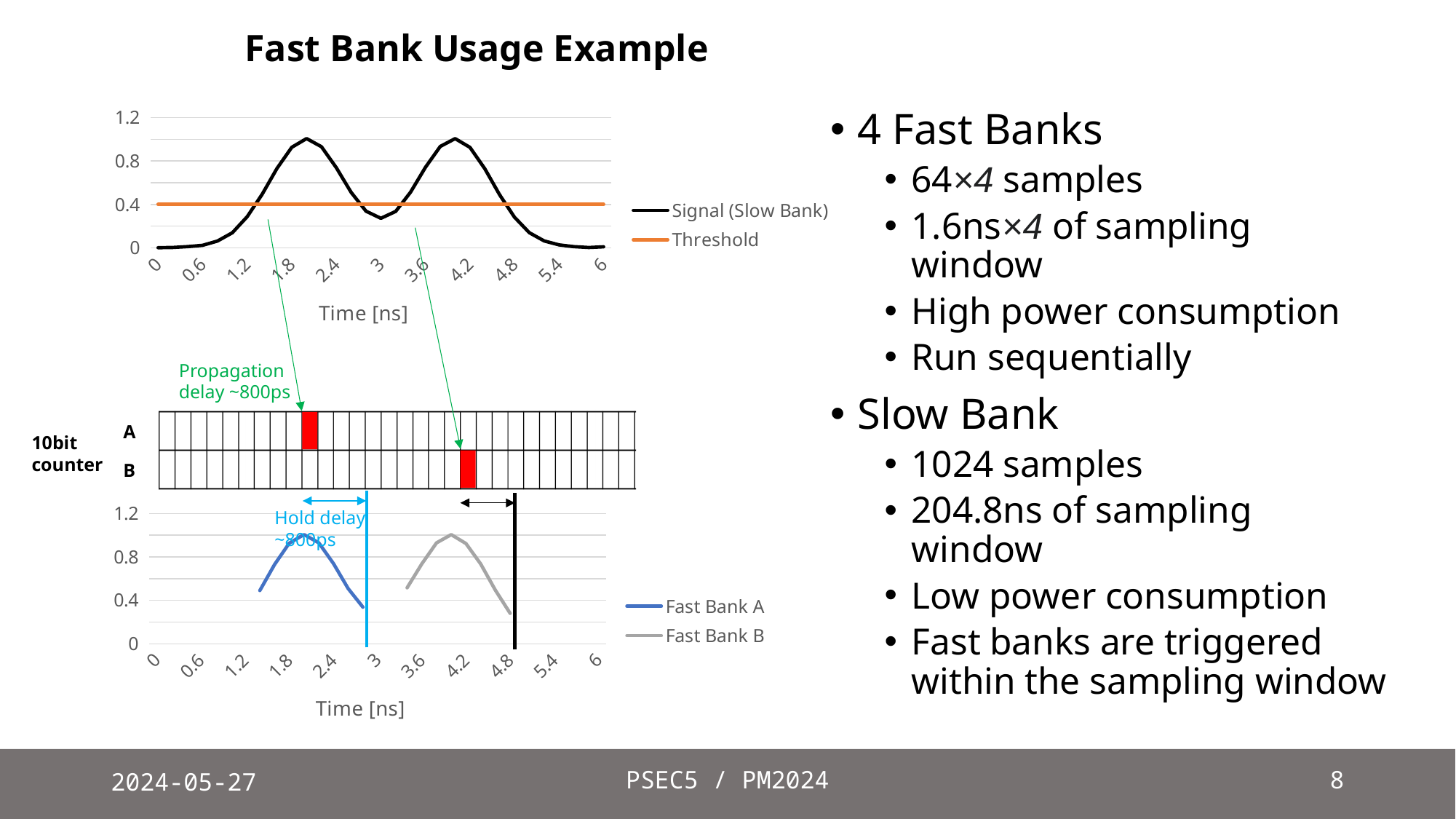
In the top chart, is the Signal (Slow Bank) value at 1.8 ns greater or less than 0.8? greater What type of chart is the bottom chart on the slide? Line chart In the bottom chart, is the Fast Bank B value at 4.8 ns greater or less than 0.4? less In the top chart, is the Signal (Slow Bank) value at 3 ns greater or less than 0.4? less In the bottom chart, which colour is used for the Fast Bank A series? Blue How many series does the legend of the bottom chart list? 2 What type of chart is the top chart on the slide? Line chart In the top chart, what value does the Threshold line sit at? 0.4 What is the x-axis title of the top chart? Time [ns] How many series does the legend of the top chart list? 2